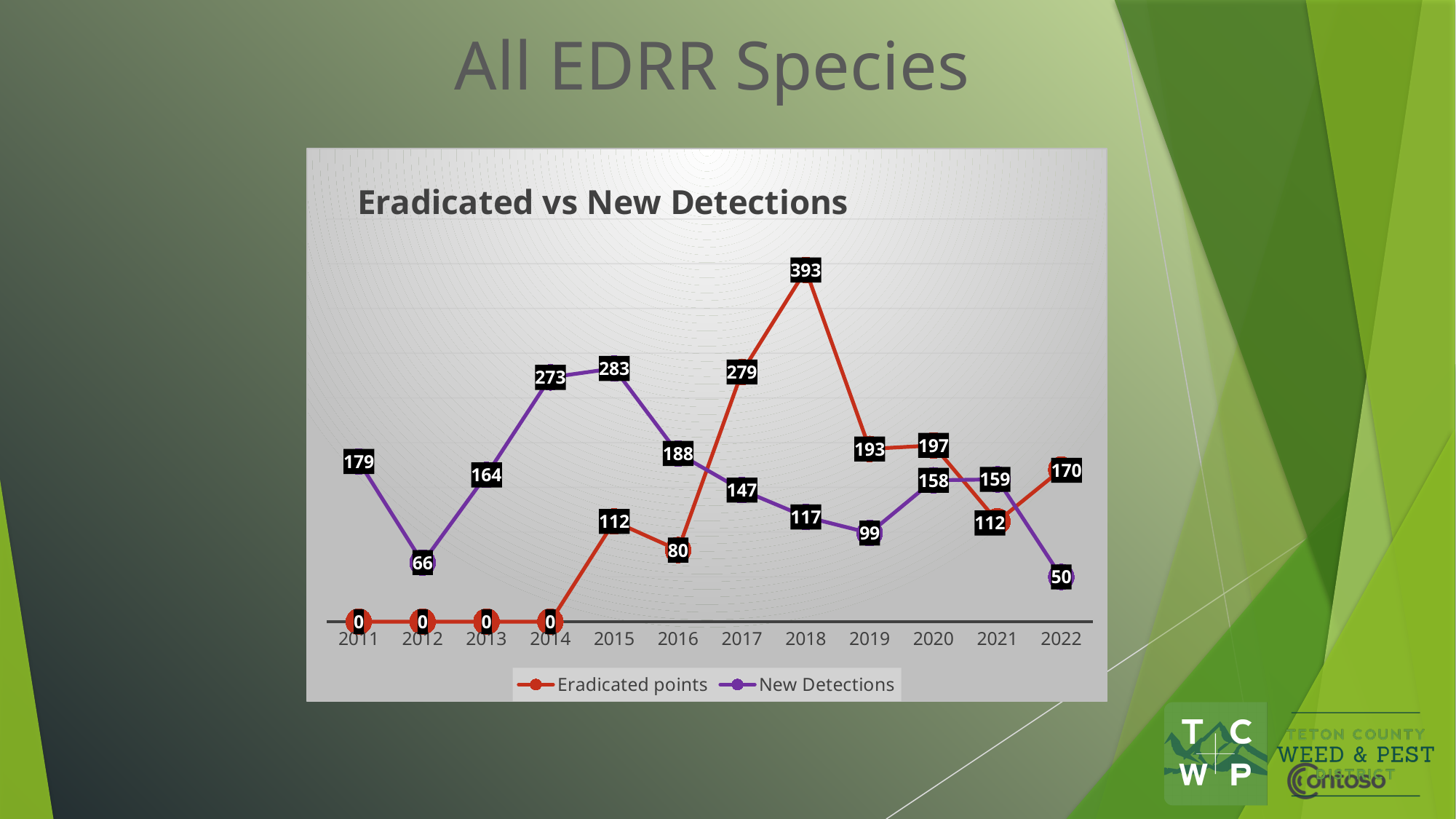
In which year is the New Detections series lowest? 2022 What is the value of Eradicated points in 2016? 80 How many years are shown on the x axis? 12 What kind of chart is shown? Line chart What is the value of Eradicated points in 2018? 393 In which year is the Eradicated points series highest? 2018 What is the value of New Detections in 2022? 50 What is the title of the chart? Eradicated vs New Detections What is the value of New Detections in 2015? 283 What is the difference between Eradicated points and New Detections in 2018? 276 Which is larger in 2014, Eradicated points or New Detections? New Detections How many series does the legend list? 2